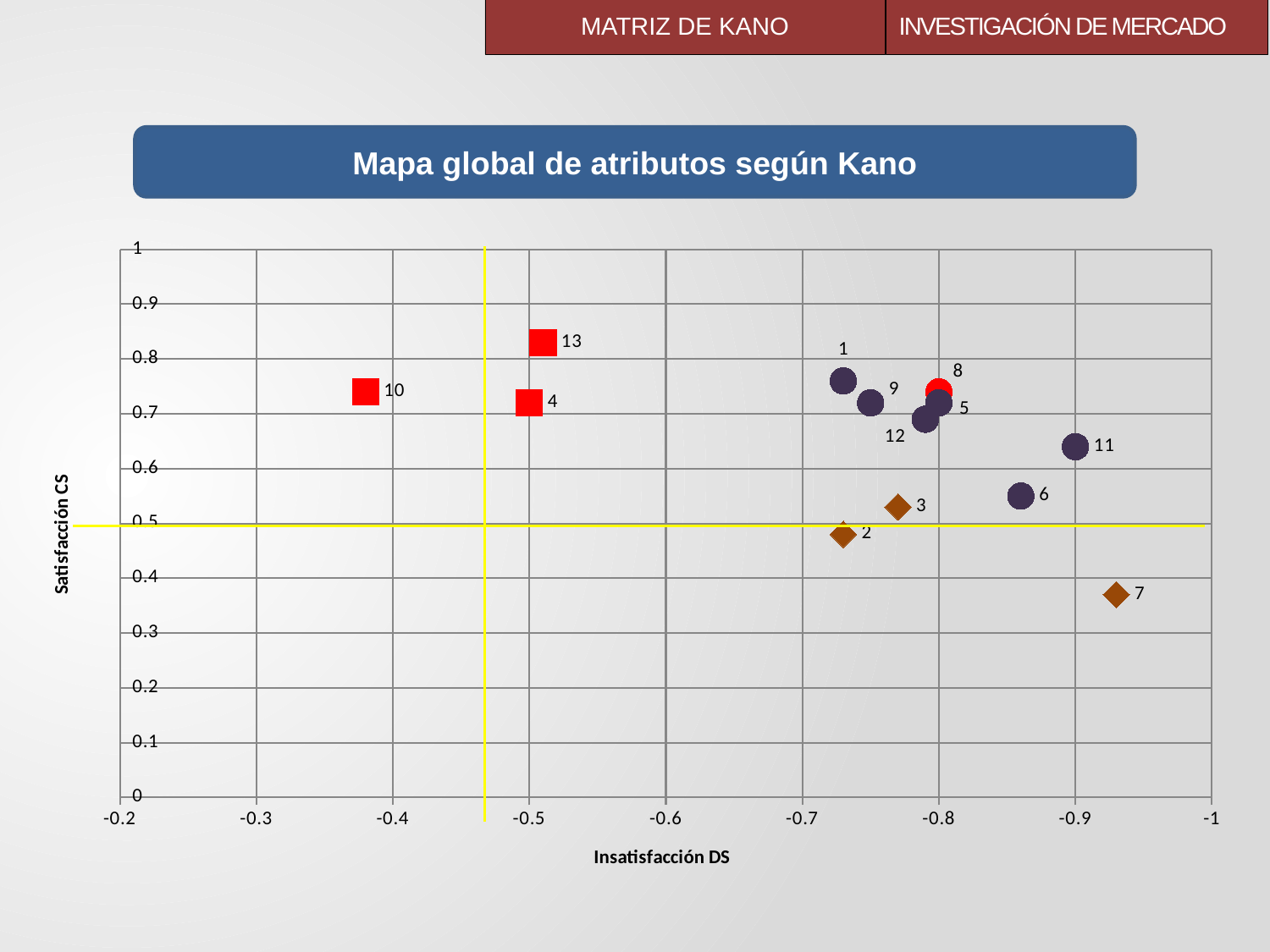
How many labelled points are plotted on the chart? 13 Is the Satisfacción CS value for point 13 greater or less than 0.8? greater Which point has the highest Satisfacción CS value? 13 What kind of chart is shown on the slide? scatter chart Is the Satisfacción CS value for point 7 greater or less than 0.5? less Which has a higher Satisfacción CS value, point 3 or point 7? 3 What is the title of the chart? Mapa global de atributos según Kano Which point has the lowest Satisfacción CS value? 7 Which point has the most negative Insatisfacción DS value? 7 Is the Satisfacción CS value for point 11 greater or less than 0.6? greater Which has a higher Satisfacción CS value, point 13 or point 4? 13 Which point has the least negative Insatisfacción DS value? 10